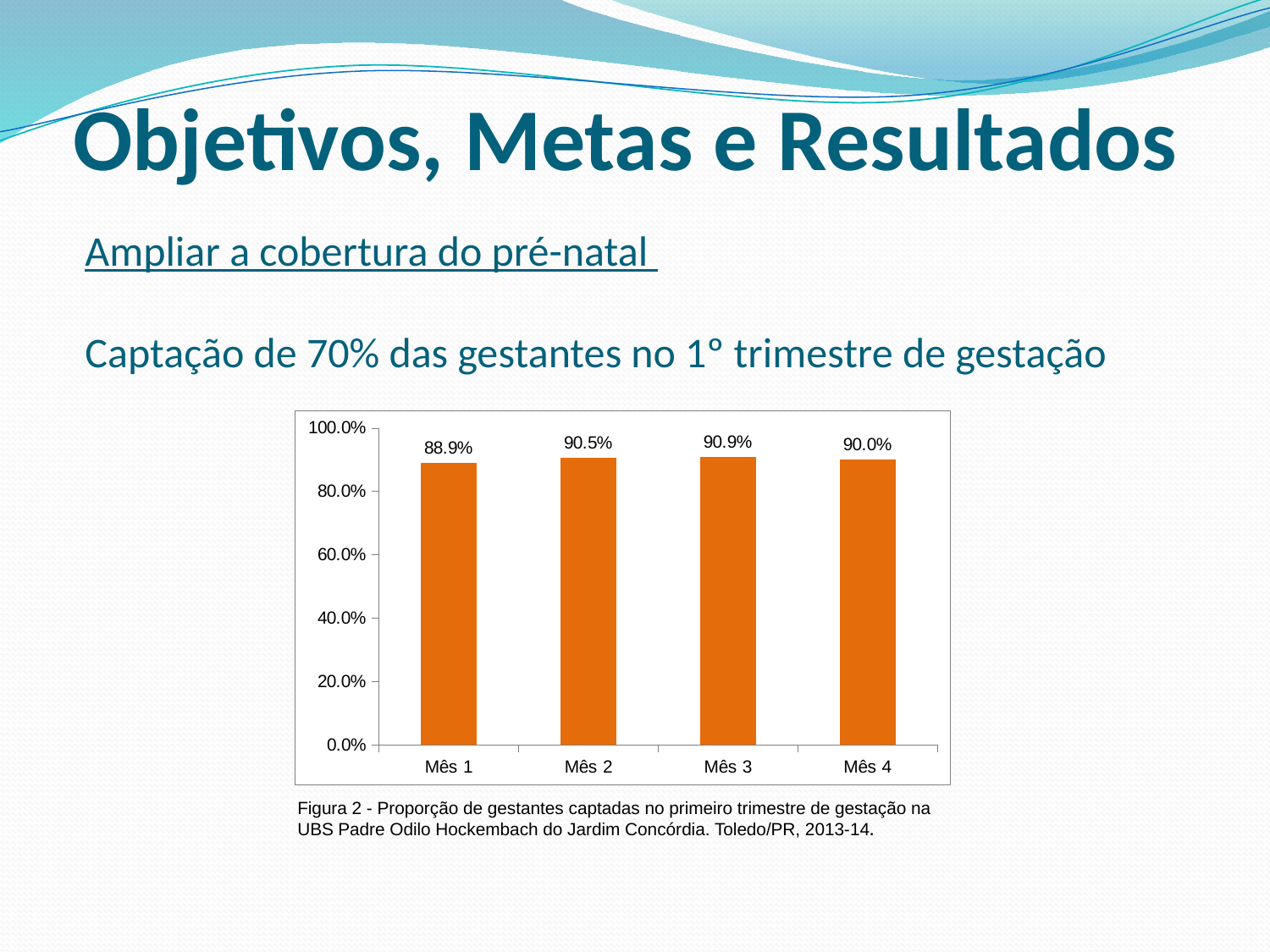
What colour are the bars in the chart? orange Is the value for Mês 2 greater or less than 80.0%? greater What is the value for Mês 4? 90.0% What kind of chart is shown on the slide? bar chart Which month has the highest value? Mês 3 Which is larger, the value for Mês 2 or the value for Mês 1? Mês 2 What is the value for Mês 3? 90.9% What is the difference between the values for Mês 3 and Mês 1? 2.0% What is the difference between the values for Mês 2 and Mês 4? 0.5% How many months are shown on the x axis? 4 Which month has the lowest value? Mês 1 What is the value for Mês 1? 88.9%